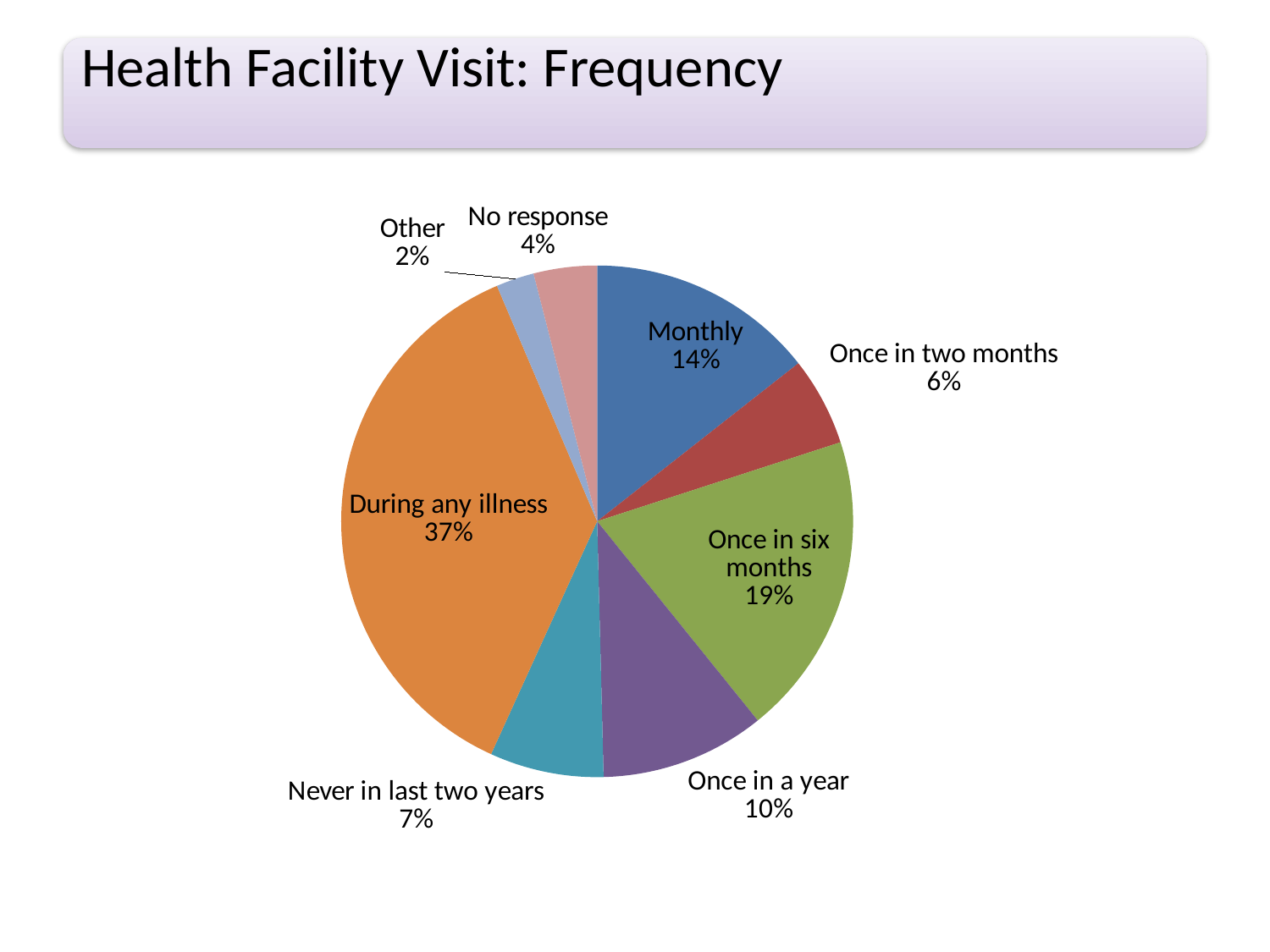
What is the value for "Monthly"? 14% Which category has the smallest slice of the pie? Other Which is larger, "Monthly" or "Once in a year"? Monthly What is the difference between the "During any illness" and "Once in six months" shares? 18% What is the value for "Never in last two years"? 7% How many categories are shown in the pie chart? 8 What is the difference between "No response" and "Other"? 2% What is the value for "Once in six months"? 19% Which category has the largest slice of the pie? During any illness What is the title of the slide containing the chart? Health Facility Visit: Frequency What kind of chart is shown on the slide? Pie chart What share of the pie is labelled "During any illness"? 37%